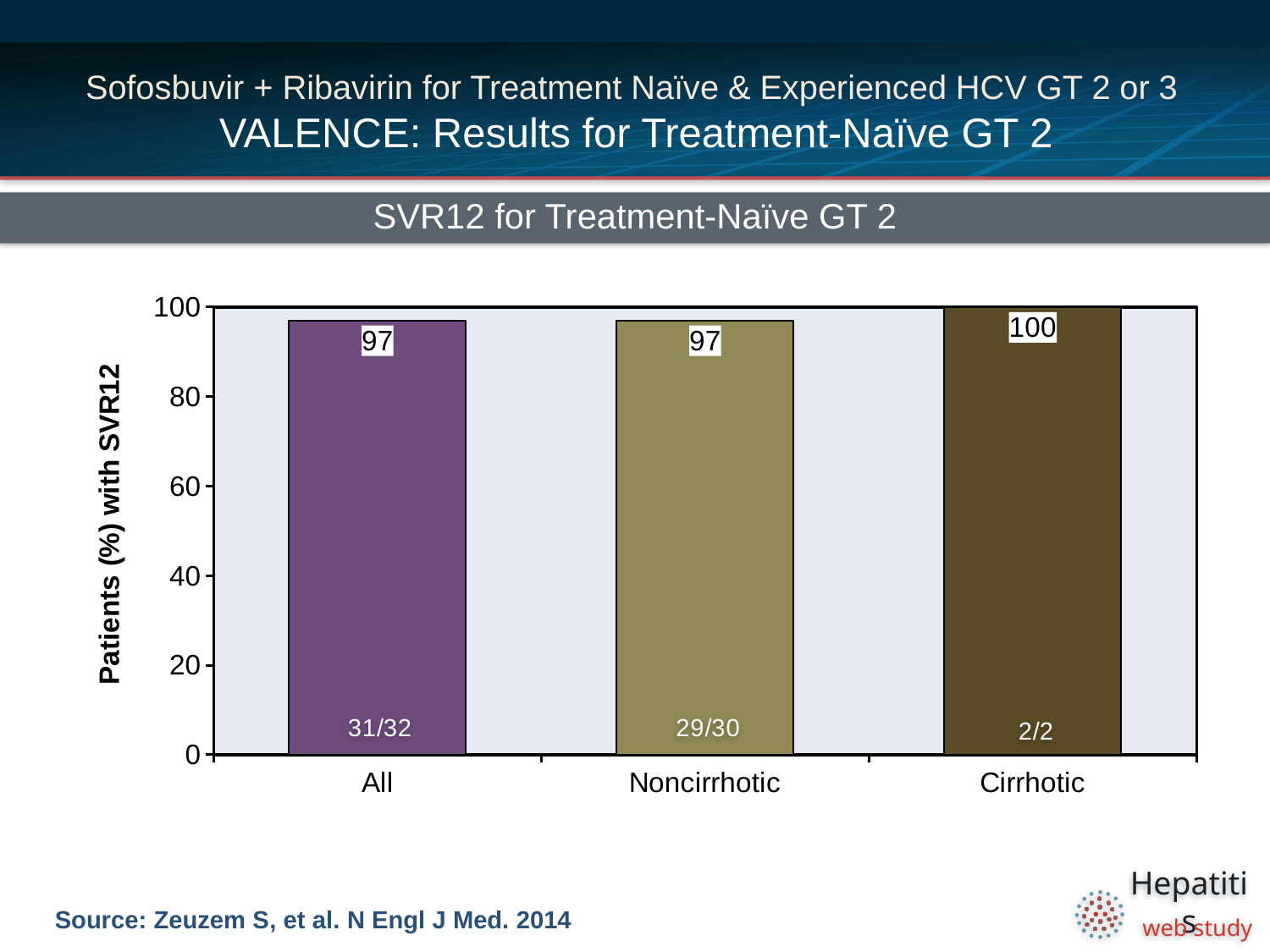
What is the difference between the SVR12 values for Cirrhotic and Noncirrhotic? 3 Is the SVR12 value for the All group greater or less than 80? greater What kind of chart is shown on the slide? bar chart How many groups are shown on the x axis? 3 Which group has the highest SVR12 value? Cirrhotic What is the SVR12 value for the All group? 97 What is the y-axis label of the chart? Patients (%) with SVR12 What is the title of the chart? SVR12 for Treatment-Naïve GT 2 What is the SVR12 value for the Cirrhotic group? 100 What is the SVR12 value for the Noncirrhotic group? 97 What fraction of patients is shown inside the All bar? 31/32 What fraction of patients is shown inside the Cirrhotic bar? 2/2